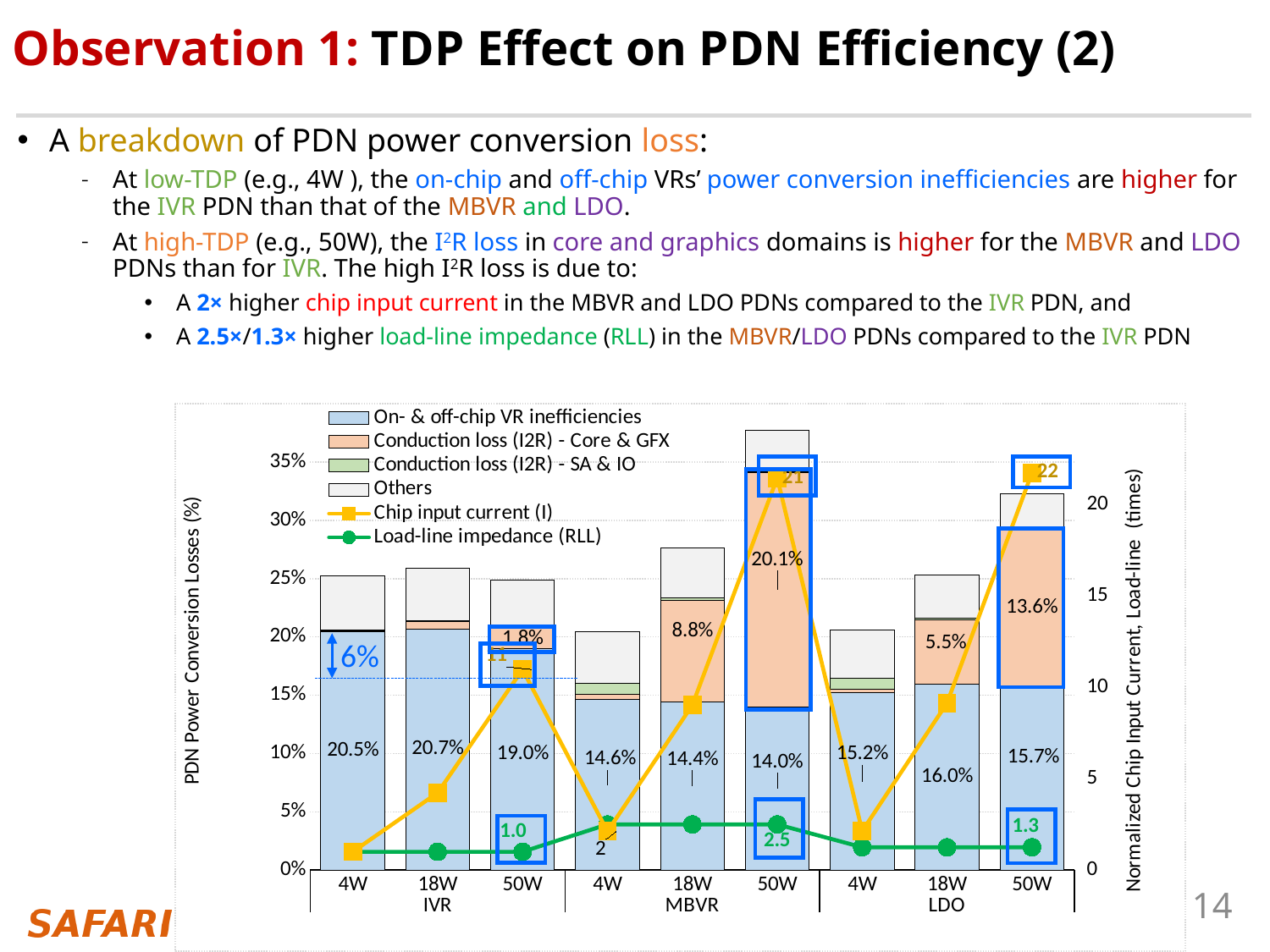
Which bar has the lowest on- & off-chip VR inefficiencies value? MBVR 50W (14.0%) How many stacked bars are plotted in the chart? 9 Which is larger, the on- & off-chip VR inefficiencies at 4W for IVR or for MBVR? IVR (20.5%) What is the normalized chip input current for the LDO PDN at 50W? 22 How many series does the legend list? 6 What is the difference between the Core & GFX conduction loss at 50W for MBVR and for LDO? 6.5 percentage points Which bar has the highest on- & off-chip VR inefficiencies value? IVR 18W (20.7%) What is the load-line impedance value for the MBVR PDN at 50W? 2.5 Is the total stacked bar height for the MBVR PDN at 50W greater or less than 35%? greater What is the on- & off-chip VR inefficiencies value for the IVR PDN at 4W? 20.5% What is the Conduction loss (I2R) - Core & GFX value for the MBVR PDN at 50W? 20.1% What is the difference in normalized chip input current at 50W between the LDO PDN and the IVR PDN? 11